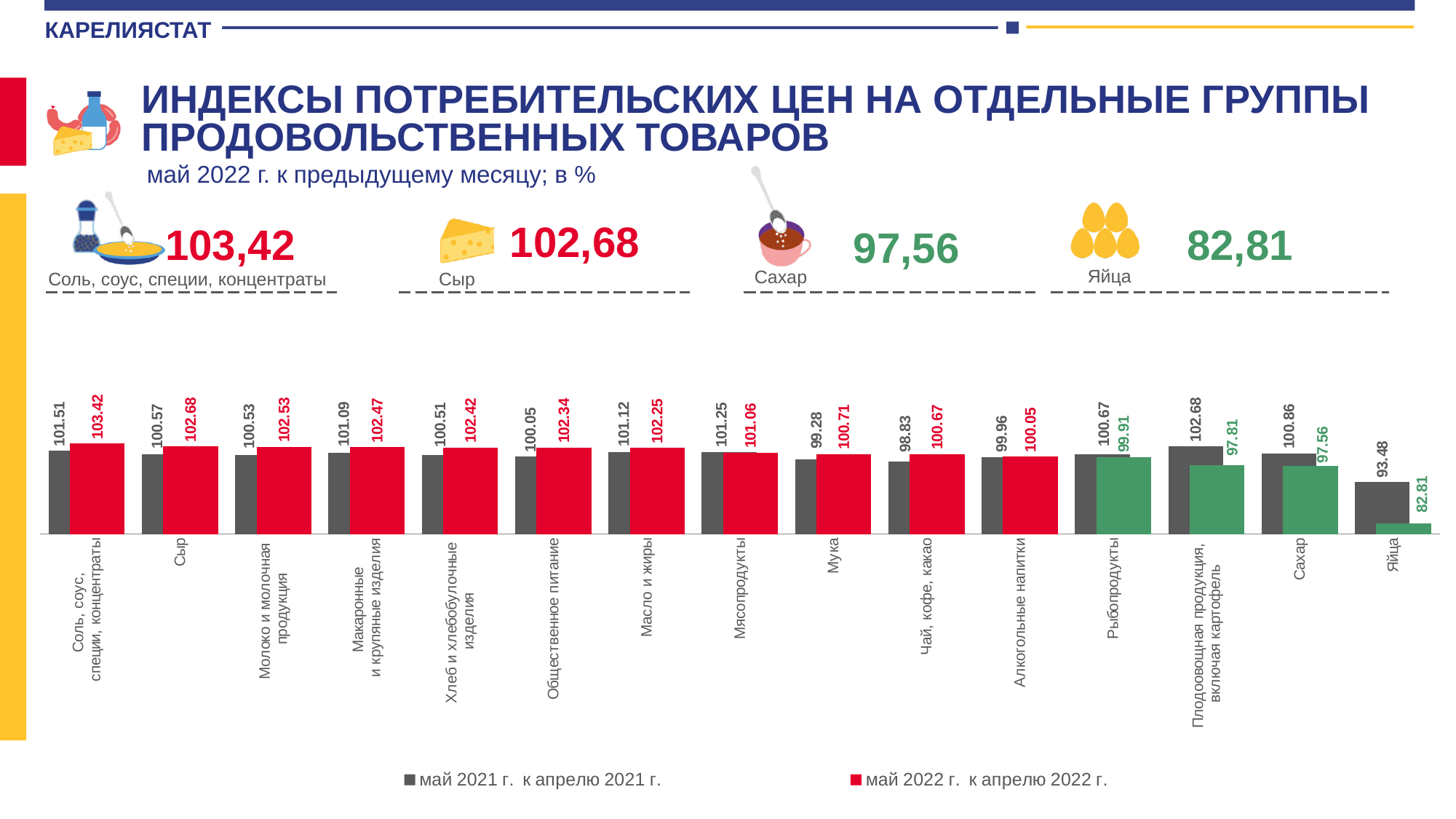
What type of chart is shown on the slide? bar chart What is the value for Сыр in the series 'май 2022 г. к апрелю 2022 г.'? 102.68 For Плодоовощная продукция, включая картофель, which series has the larger value: 'май 2021 г. к апрелю 2021 г.' or 'май 2022 г. к апрелю 2022 г.'? май 2021 г. к апрелю 2021 г. Which category has the highest value in the series 'май 2022 г. к апрелю 2022 г.'? Соль, соус, специи, концентраты How many product categories are shown on the x axis of the chart? 15 How many series does the chart legend list? 2 What is the value for Сахар in the series 'май 2022 г. к апрелю 2022 г.'? 97.56 What is the value for Яйца in the series 'май 2021 г. к апрелю 2021 г.'? 93.48 What colour are the 'май 2022 г. к апрелю 2022 г.' bars for Рыбопродукты, Плодоовощная продукция, Сахар and Яйца? green What is the value for Мука in the series 'май 2022 г. к апрелю 2022 г.'? 100.71 What is the difference between the 'май 2022 г. к апрелю 2022 г.' and 'май 2021 г. к апрелю 2021 г.' values for Яйца? 10.67 Which category has the lowest value in the series 'май 2021 г. к апрелю 2021 г.'? Яйца